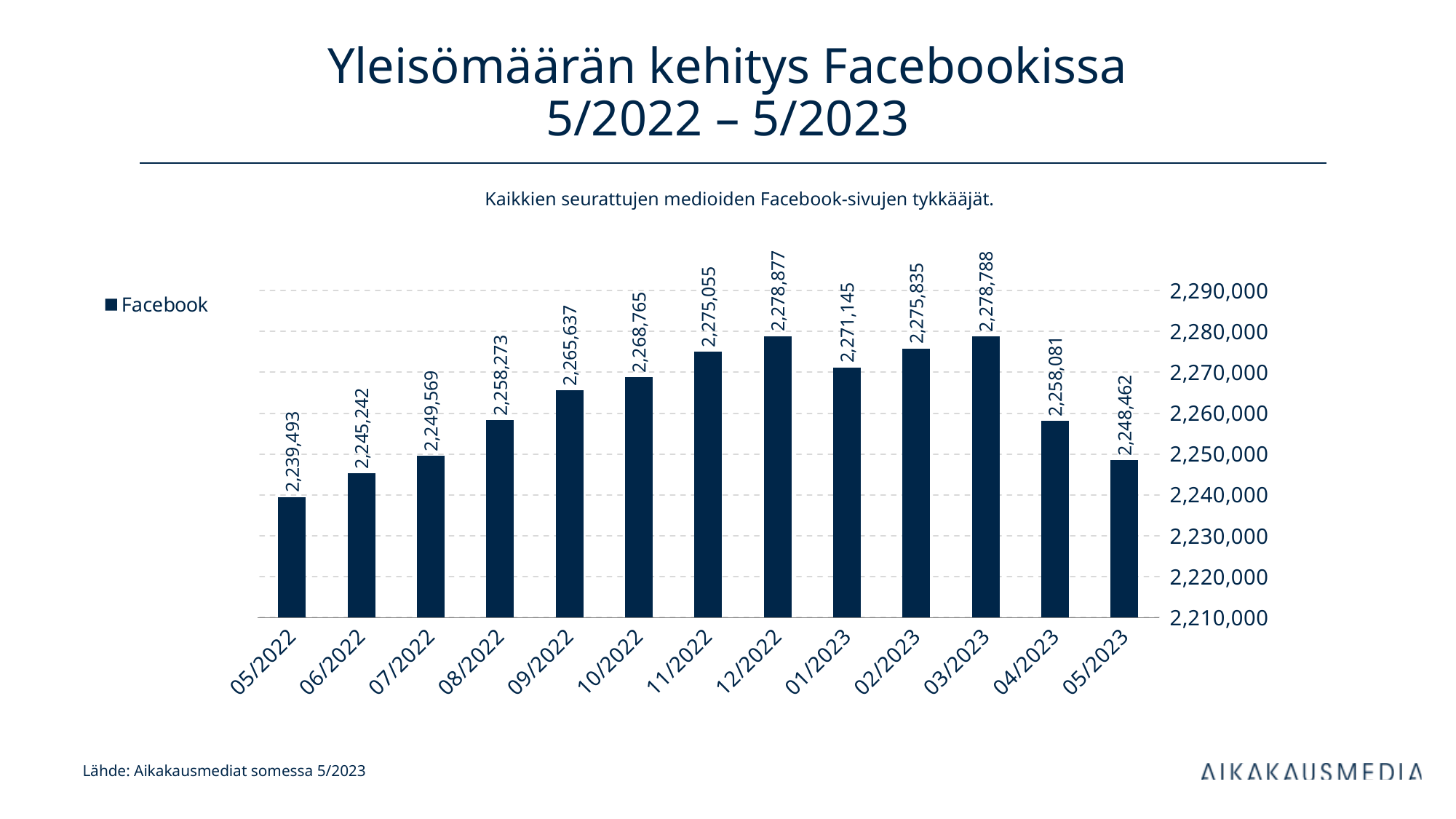
What is the difference between the values for 05/2023 and 05/2022? 8,969 Do the values rise or fall from 05/2022 to 12/2022? rise What is the value for 05/2022? 2,239,493 How many months are shown on the x axis? 13 What is the value for 12/2022? 2,278,877 Is the value for 11/2022 greater or less than 2,270,000? greater What kind of chart is shown? bar chart Which month has the lowest value? 05/2022 What is the value for 04/2023? 2,258,081 Which is larger, the value for 10/2022 or the value for 01/2023? 01/2023 What is the difference between the values for 03/2023 and 04/2023? 20,707 How many series does the legend list? 1